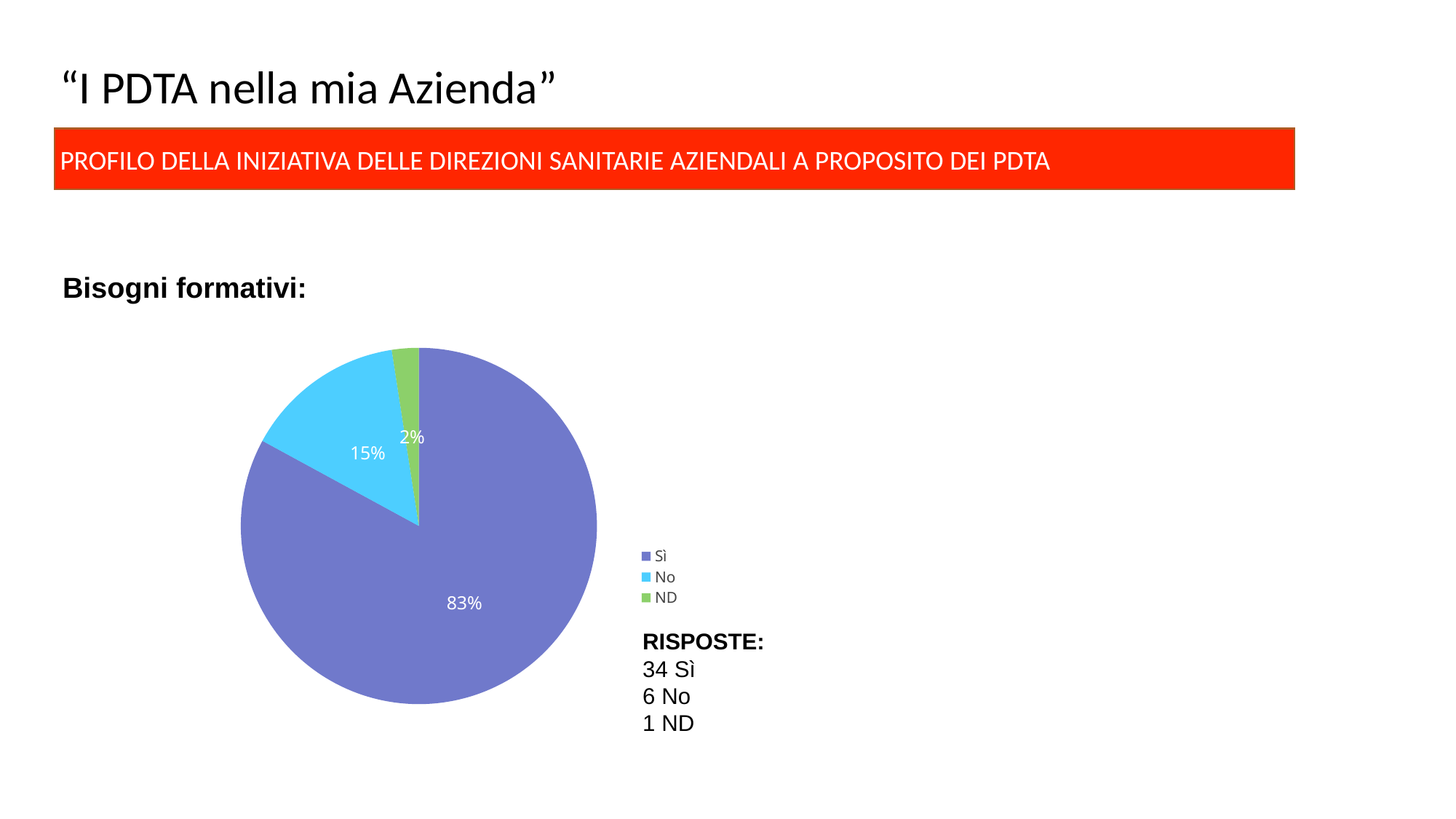
How many slices does the pie chart have? 3 Which category has the smallest slice of the pie? ND How many entries does the legend list? 3 What colour is the "No" slice in the pie chart? Light blue What is the heading shown above the pie chart? Bisogni formativi: Which category has the largest slice of the pie? Sì What is the difference in percentage points between the "Sì" and "No" slices? 68 What share of the pie does the "Sì" slice represent? 83% What kind of chart is shown on the slide? Pie chart What share of the pie does the "No" slice represent? 15% What share of the pie does the "ND" slice represent? 2% Which slice is larger, "No" or "ND"? No